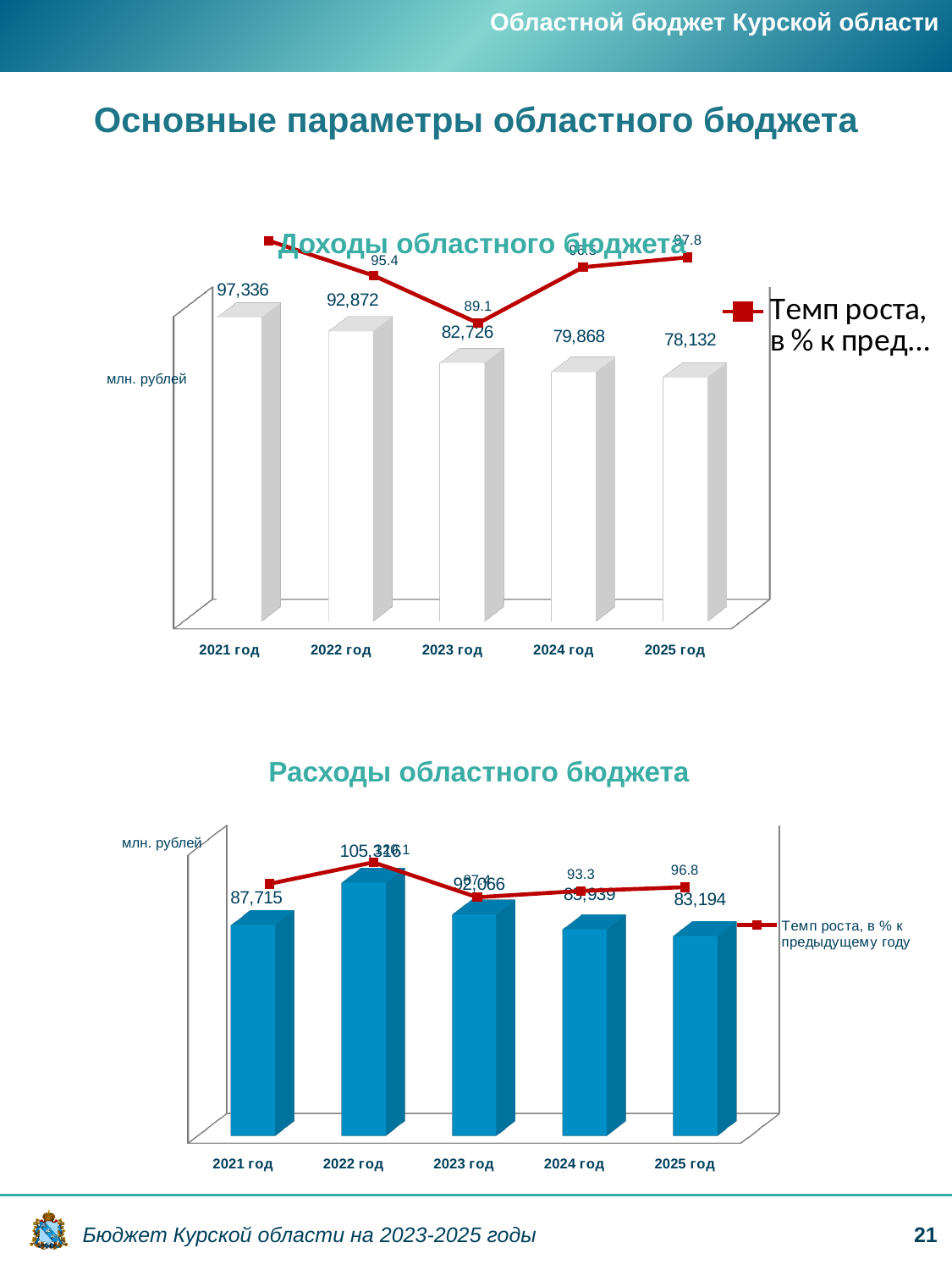
In the 'Доходы областного бюджета' chart, do the bar values rise or fall from 2021 год to 2025 год? fall In the 'Доходы областного бюджета' chart, which year has the lowest bar? 2025 год In the 'Доходы областного бюджета' chart, what is the growth rate (Темп роста) value for 2023 год? 89.1 In the 'Доходы областного бюджета' chart, what is the value for 2021 год? 97,336 In the 'Расходы областного бюджета' chart, what is the growth rate (Темп роста) value for 2025 год? 96.8 In the 'Доходы областного бюджета' chart, which year has the highest bar? 2021 год In the 'Доходы областного бюджета' chart, what is the difference between the values for 2021 год and 2022 год? 4,464 How many years are shown on the x axis of the 'Расходы областного бюджета' chart? 5 In the 'Расходы областного бюджета' chart, which year has the highest bar? 2022 год In the 'Доходы областного бюджета' chart, what is the value for 2025 год? 78,132 In the 'Расходы областного бюджета' chart, what is the value for 2025 год? 83,194 In the 'Расходы областного бюджета' chart, what is the value for 2022 год? 105,316